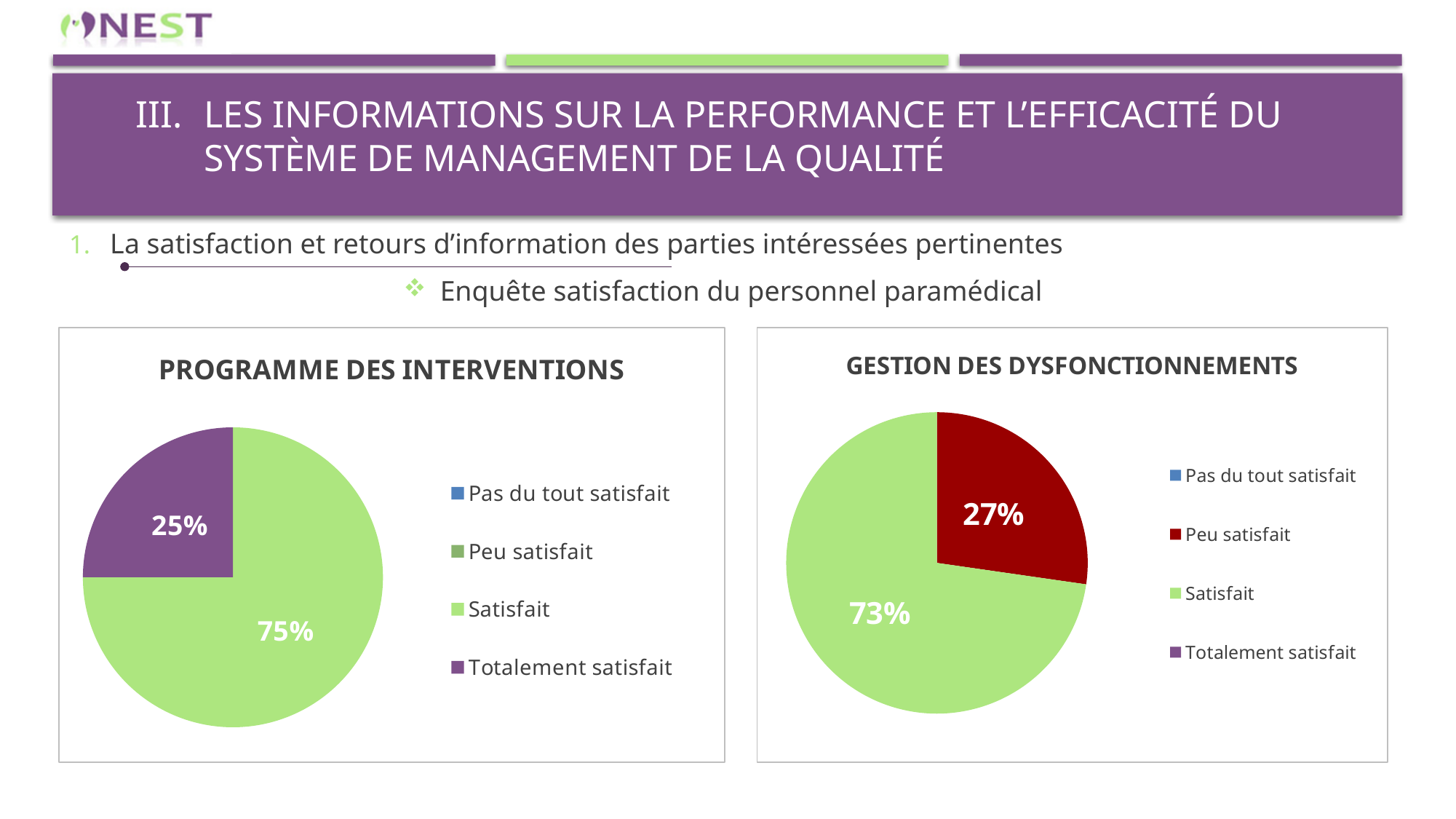
In the 'GESTION DES DYSFONCTIONNEMENTS' chart, what percentage is shown for 'Peu satisfait'? 27% In the 'PROGRAMME DES INTERVENTIONS' chart, what percentage is shown for 'Totalement satisfait'? 25% In the 'GESTION DES DYSFONCTIONNEMENTS' chart, what percentage is shown for 'Satisfait'? 73% In the 'PROGRAMME DES INTERVENTIONS' chart, which category has the largest slice? Satisfait In the 'PROGRAMME DES INTERVENTIONS' chart, what is the difference between the 'Satisfait' and 'Totalement satisfait' percentages? 50% Which is larger: the 'Satisfait' share in the 'PROGRAMME DES INTERVENTIONS' chart or the 'Satisfait' share in the 'GESTION DES DYSFONCTIONNEMENTS' chart? PROGRAMME DES INTERVENTIONS In the 'GESTION DES DYSFONCTIONNEMENTS' chart, what is the difference between the 'Satisfait' and 'Peu satisfait' percentages? 46% What type of chart is the 'PROGRAMME DES INTERVENTIONS' chart? Pie chart How many entries does the legend of the 'GESTION DES DYSFONCTIONNEMENTS' chart list? 4 In the 'GESTION DES DYSFONCTIONNEMENTS' chart, which category has the largest slice? Satisfait In the 'GESTION DES DYSFONCTIONNEMENTS' chart, what colour is the 'Peu satisfait' slice? Dark red In the 'PROGRAMME DES INTERVENTIONS' chart, what percentage is shown for 'Satisfait'? 75%